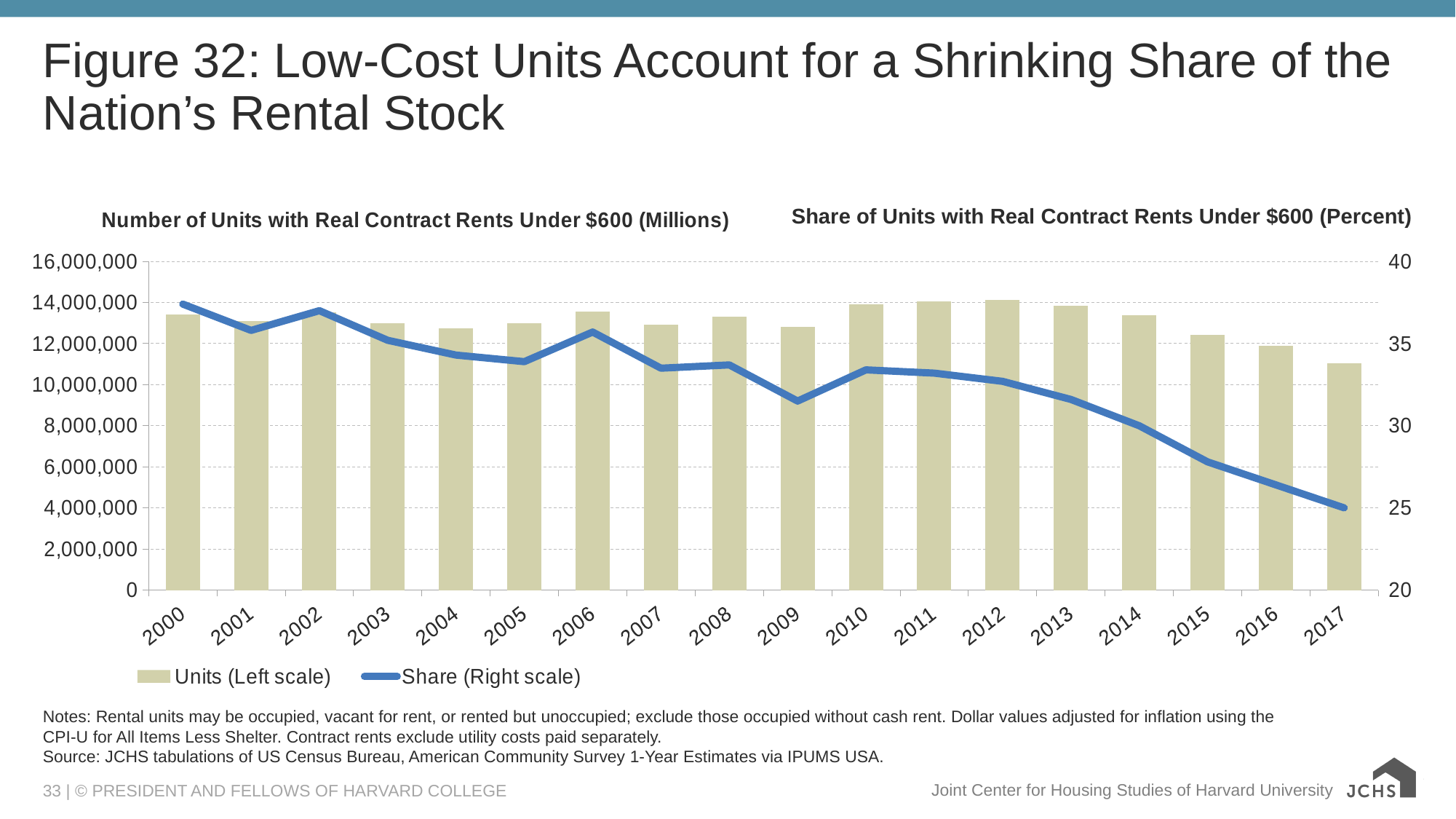
Which year has the lowest share of units with real contract rents under $600? 2017 What kind of chart is shown on the slide? A combination bar and line chart Which year has the lowest number of units with real contract rents under $600? 2017 Is the share of units for 2015 greater or less than 30? less Is the share of units for 2000 greater or less than 35? greater How many series does the legend list? 2 Is the number of units for 2012 greater or less than 12,000,000? greater How many years are shown on the x axis? 18 Which year has the larger number of units, 2000 or 2017? 2000 Does the share of units with real contract rents under $600 generally rise or fall from 2000 to 2017? fall